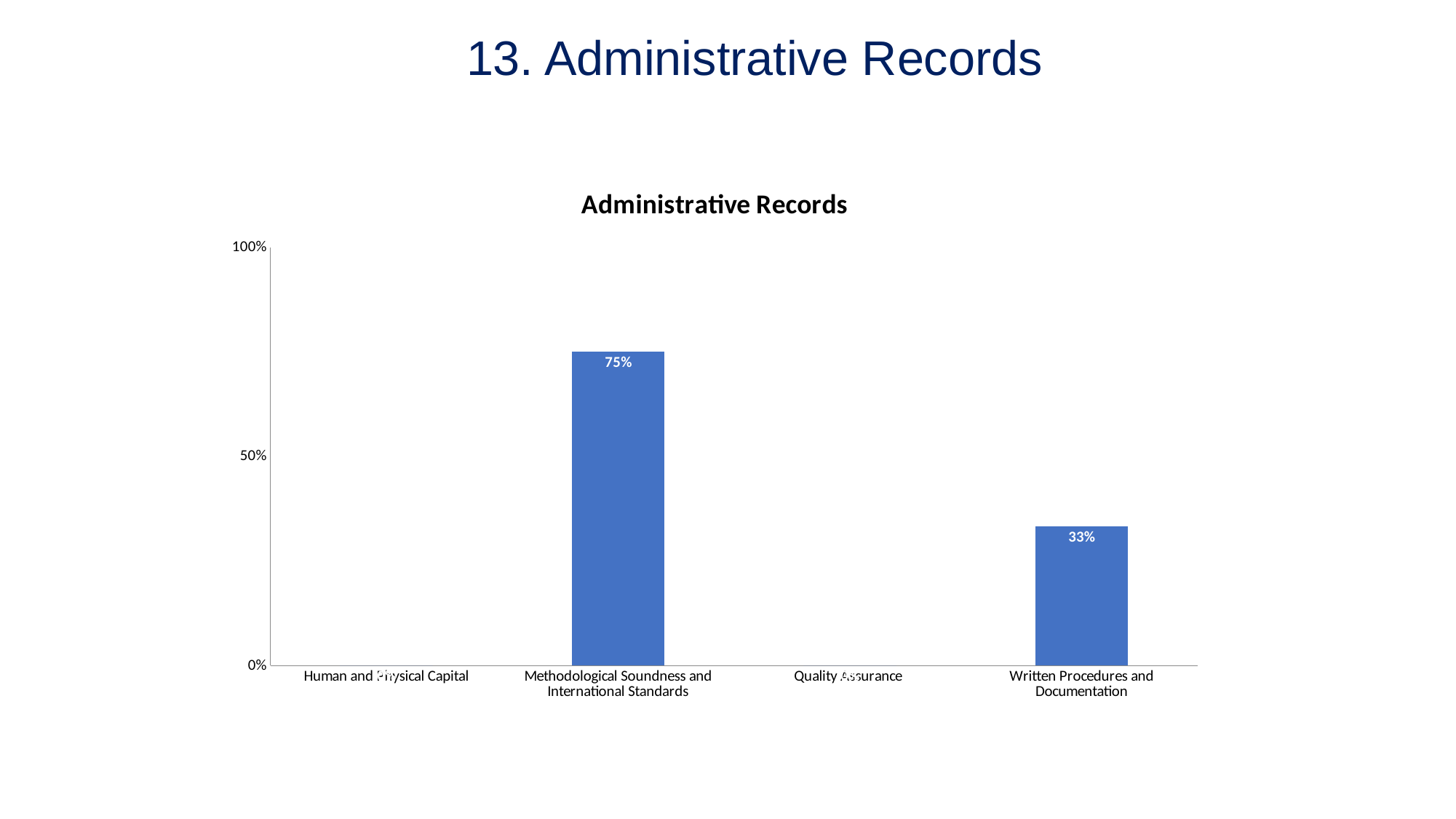
What is the maximum value shown on the y axis? 100% What is the difference between the values for Methodological Soundness and International Standards and Written Procedures and Documentation? 42% How many categories are shown on the x axis? 4 Which is larger, the value for Methodological Soundness and International Standards or the value for Written Procedures and Documentation? Methodological Soundness and International Standards Is the value for Methodological Soundness and International Standards greater or less than 50%? greater What kind of chart is shown on the slide? bar chart What is the value for Written Procedures and Documentation? 33% Is the value for Quality Assurance greater or less than 50%? less Is the value for Written Procedures and Documentation greater or less than 50%? less Which category has the highest value? Methodological Soundness and International Standards What is the value for Methodological Soundness and International Standards? 75% What is the title of the chart? Administrative Records